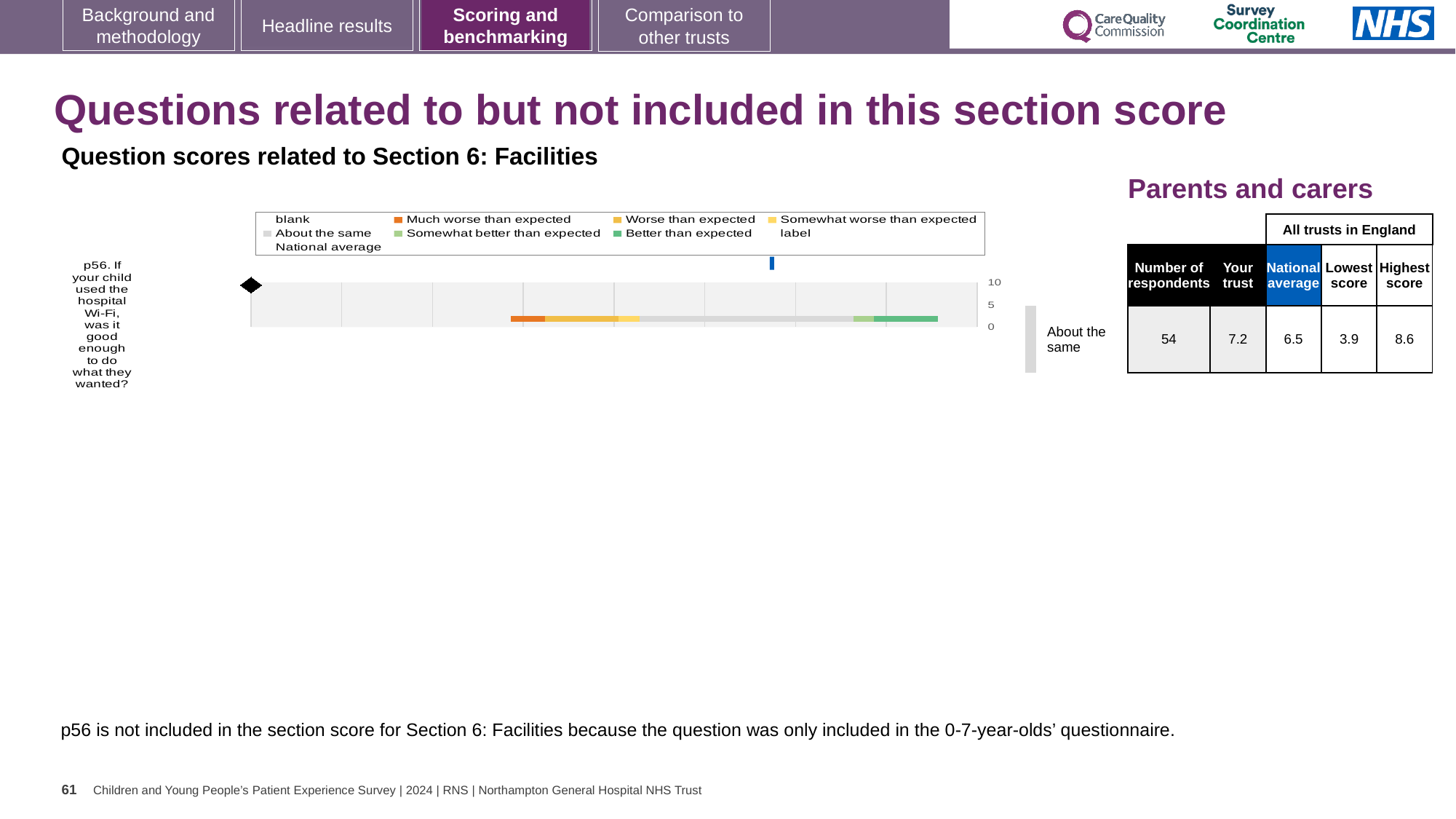
Which colour does the legend use for 'Much worse than expected'? orange What is the highest score across all trusts in England for p56? 8.6 What is the difference between the highest score and the lowest score for p56? 4.7 For p56, which is larger: the 'Your trust' score or the national average? Your trust How many questions are plotted in the chart? 1 What is the national average score for p56 shown in the table? 6.5 How many respondents answered p56 according to the table? 54 What is the lowest score across all trusts in England for p56? 3.9 What is the 'Your trust' score for p56 in the table next to the chart? 7.2 What kind of chart is used to show the p56 question score? bar chart What is the difference between the 'Your trust' score and the national average for p56? 0.7 What is the highest tick value shown on the chart's score axis? 10